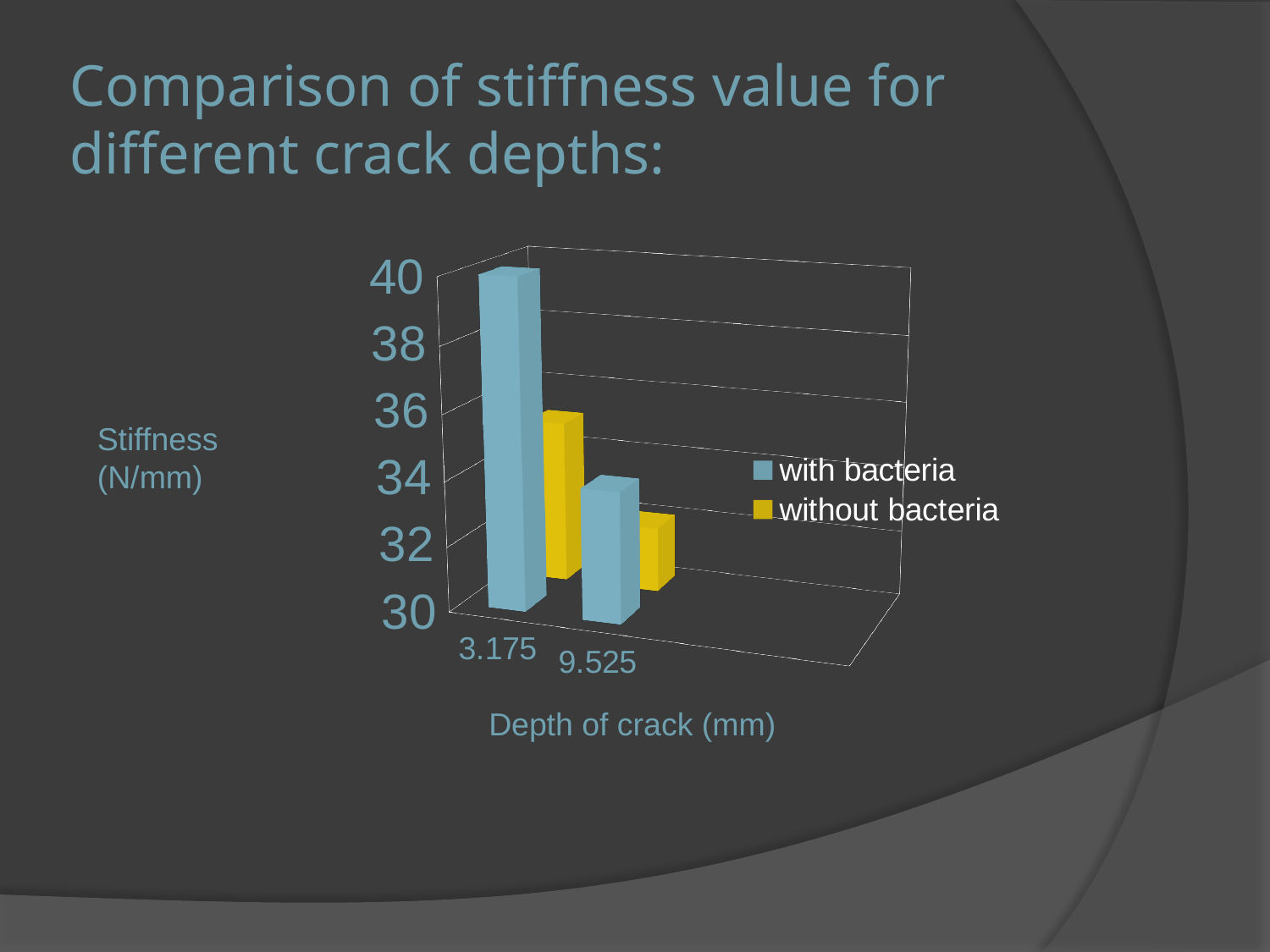
How many crack depth categories are shown on the x axis? 2 At a crack depth of 9.525 mm, which is larger: the stiffness with bacteria or without bacteria? with bacteria What is the label of the x axis? Depth of crack (mm) Is the stiffness value without bacteria at a crack depth of 3.175 mm greater or less than 32? greater Which colour represents the 'without bacteria' series in the legend? yellow What type of chart is shown on the slide? bar chart How many series does the legend list? 2 Is the stiffness value with bacteria at a crack depth of 3.175 mm greater or less than 38? greater Is the stiffness value with bacteria at a crack depth of 9.525 mm greater or less than 36? less Which series has the highest stiffness value at a crack depth of 3.175 mm? with bacteria Does the stiffness with bacteria rise or fall as the crack depth increases from 3.175 mm to 9.525 mm? fall Which bar shows the lowest stiffness value on the chart? without bacteria at 9.525